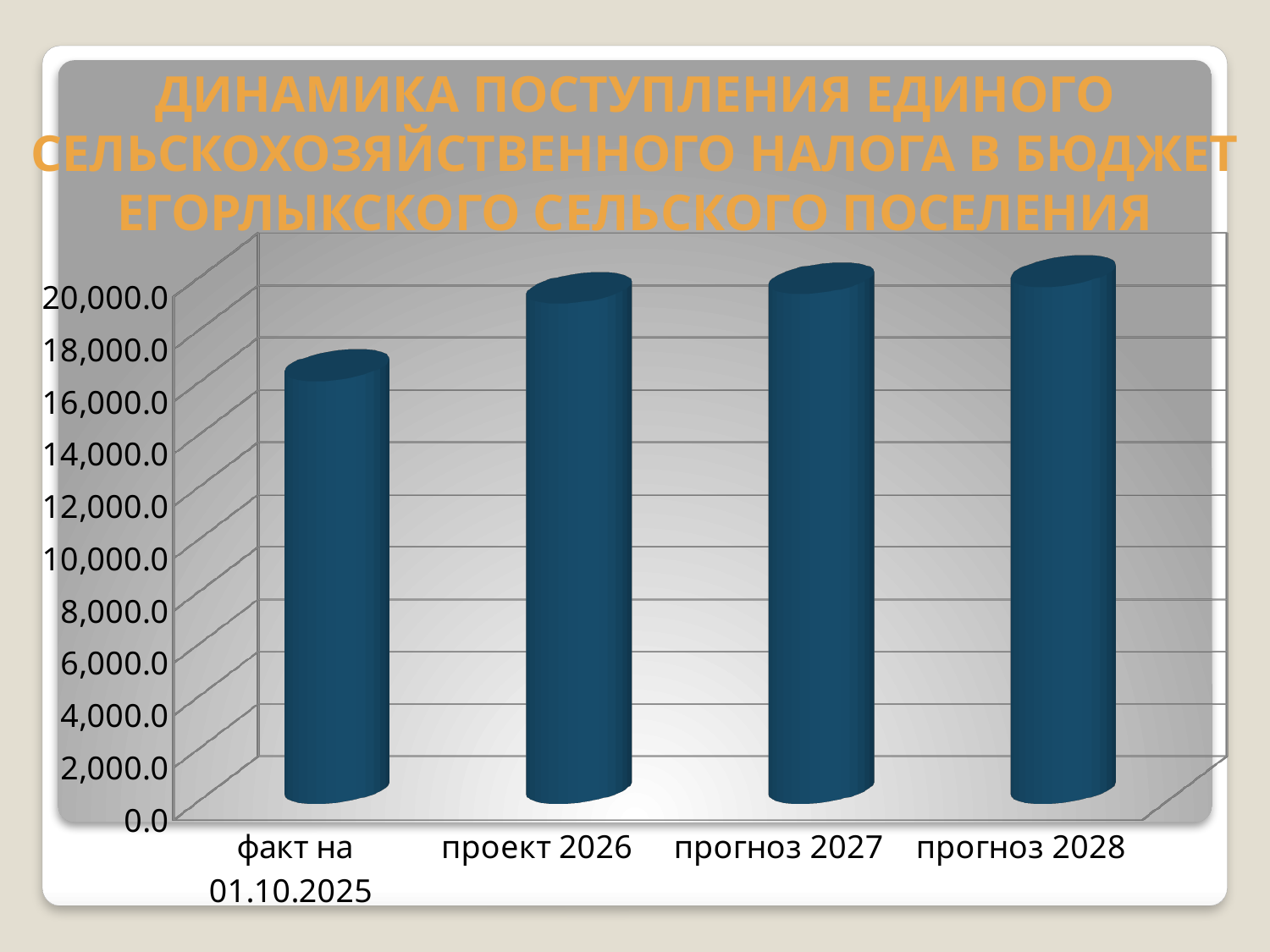
Do the values generally rise or fall from left to right along the x axis? rise Is the value for "факт на 01.10.2025" greater or less than 18,000.0? less Is the value for "прогноз 2027" greater or less than 16,000.0? greater Which is larger, the value for "факт на 01.10.2025" or the value for "проект 2026"? проект 2026 How many categories are shown on the x axis of the chart? 4 Which is larger, the value for "прогноз 2028" or the value for "факт на 01.10.2025"? прогноз 2028 What is the highest tick value shown on the vertical axis of the chart? 20,000.0 Which category has the lowest value in the chart? факт на 01.10.2025 Is the value for "прогноз 2028" greater or less than 18,000.0? greater What kind of chart is shown on the slide? bar chart